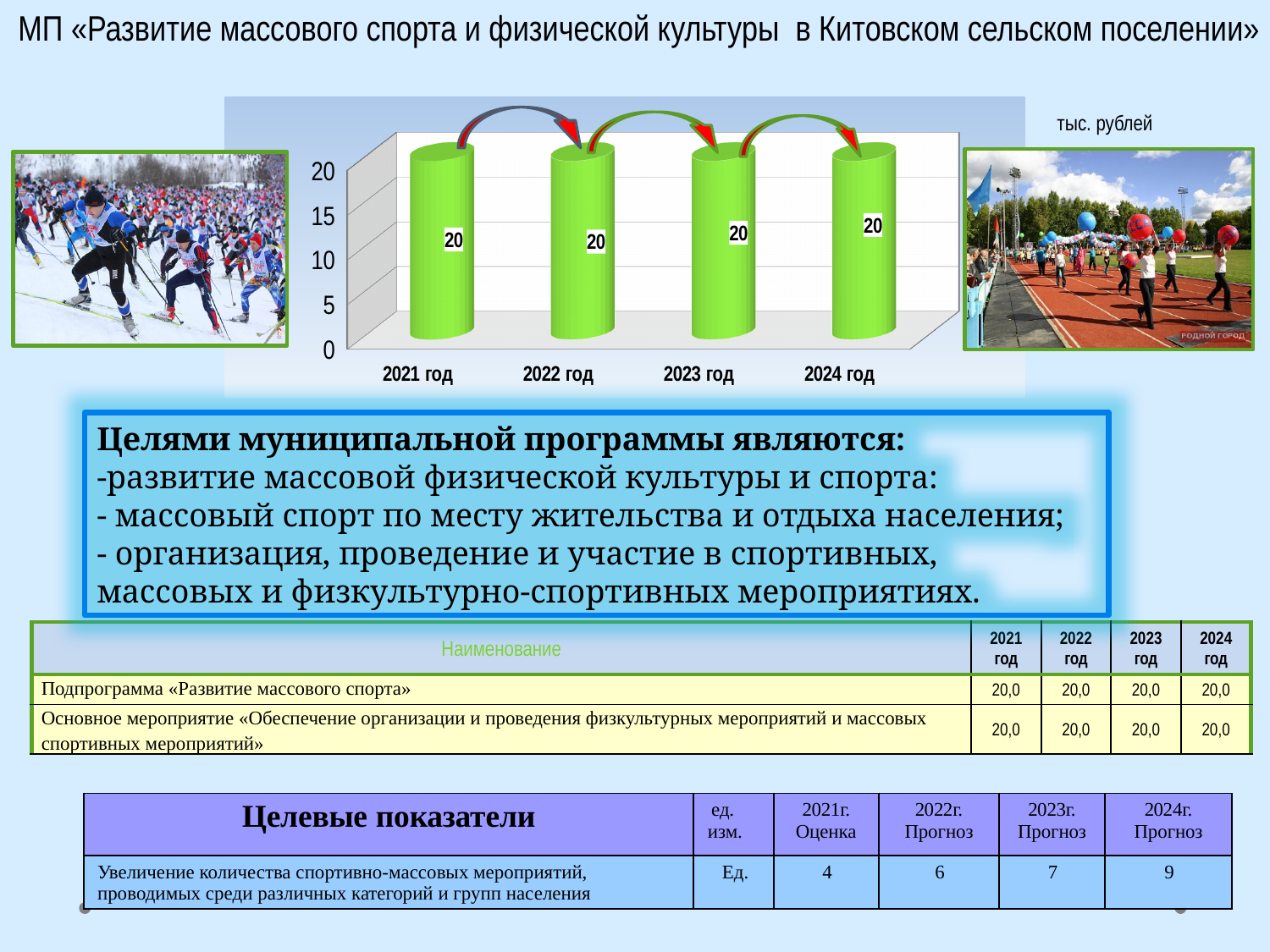
Is the value for 2023 год greater or less than 10? greater What is the value for 2021 год on the chart? 20 What is the value for 2023 год on the chart? 20 How many categories (years) are shown on the chart? 4 What is the value for 2024 год on the chart? 20 Which is larger, the value for 2021 год or the value for 2023 год? They are equal What kind of chart is shown on the slide? Bar chart What is the difference between the values for 2024 год and 2021 год? 0 Do the values rise, fall or stay the same from 2021 год to 2024 год? Stay the same What unit is indicated next to the chart? тыс. рублей Is the value for 2022 год greater or less than 15? greater What is the value for 2022 год on the chart? 20